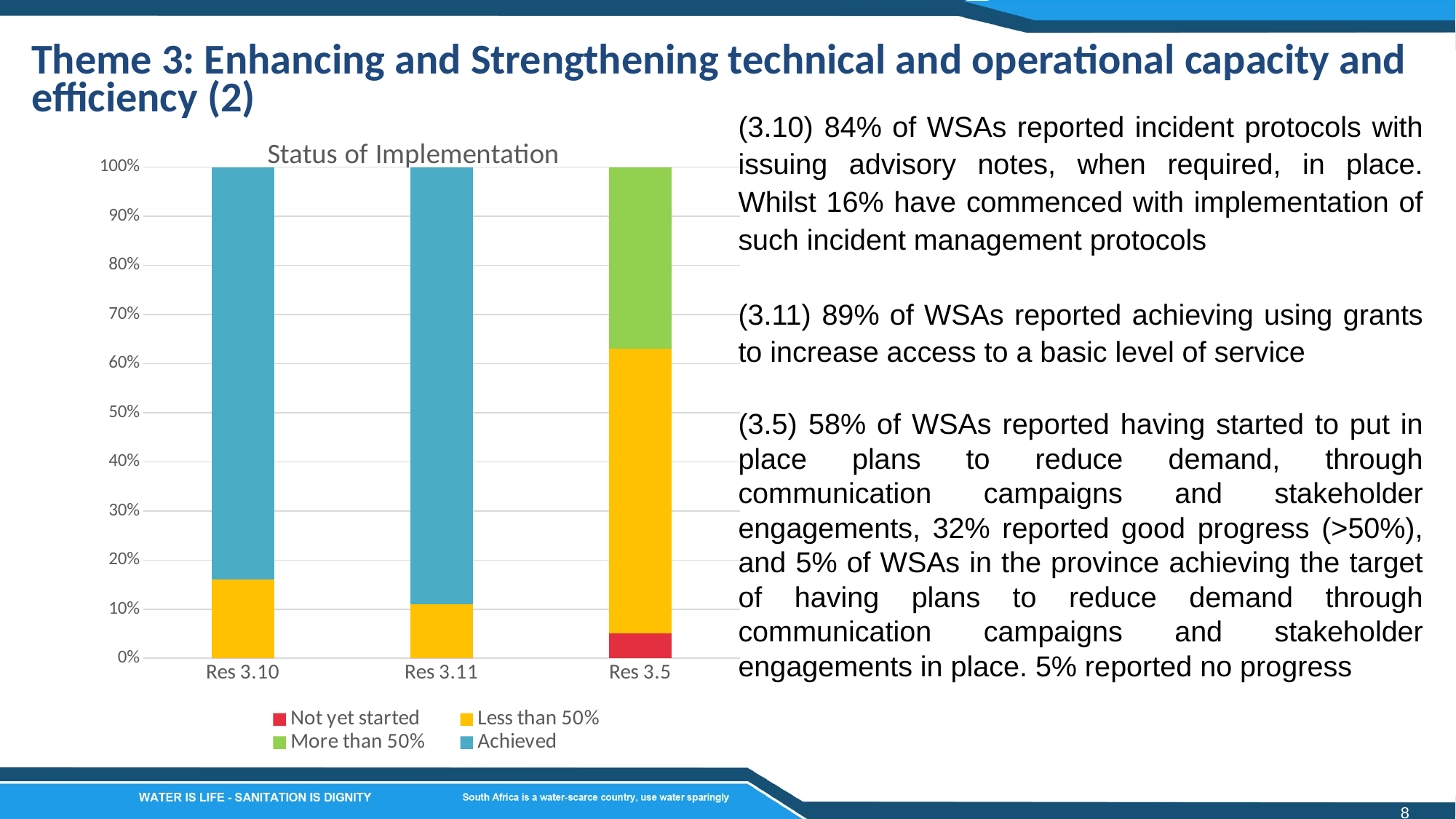
Is the 'Less than 50%' value for Res 3.11 greater or less than 20%? less Which is larger, the 'Achieved' value for Res 3.10 or for Res 3.11? Res 3.11 What is the title of the chart? Status of Implementation Is the 'Less than 50%' value for Res 3.5 greater or less than 50%? greater How many series does the chart legend list? 4 Is the 'Achieved' value for Res 3.10 greater or less than 80%? greater What is the total of the stacked bar for Res 3.10? 100% What kind of chart is shown on the slide? Stacked bar chart Which category has the largest 'Less than 50%' segment? Res 3.5 How many categories are shown on the x axis of the chart? 3 Which colour represents the 'Achieved' series in the chart? Blue